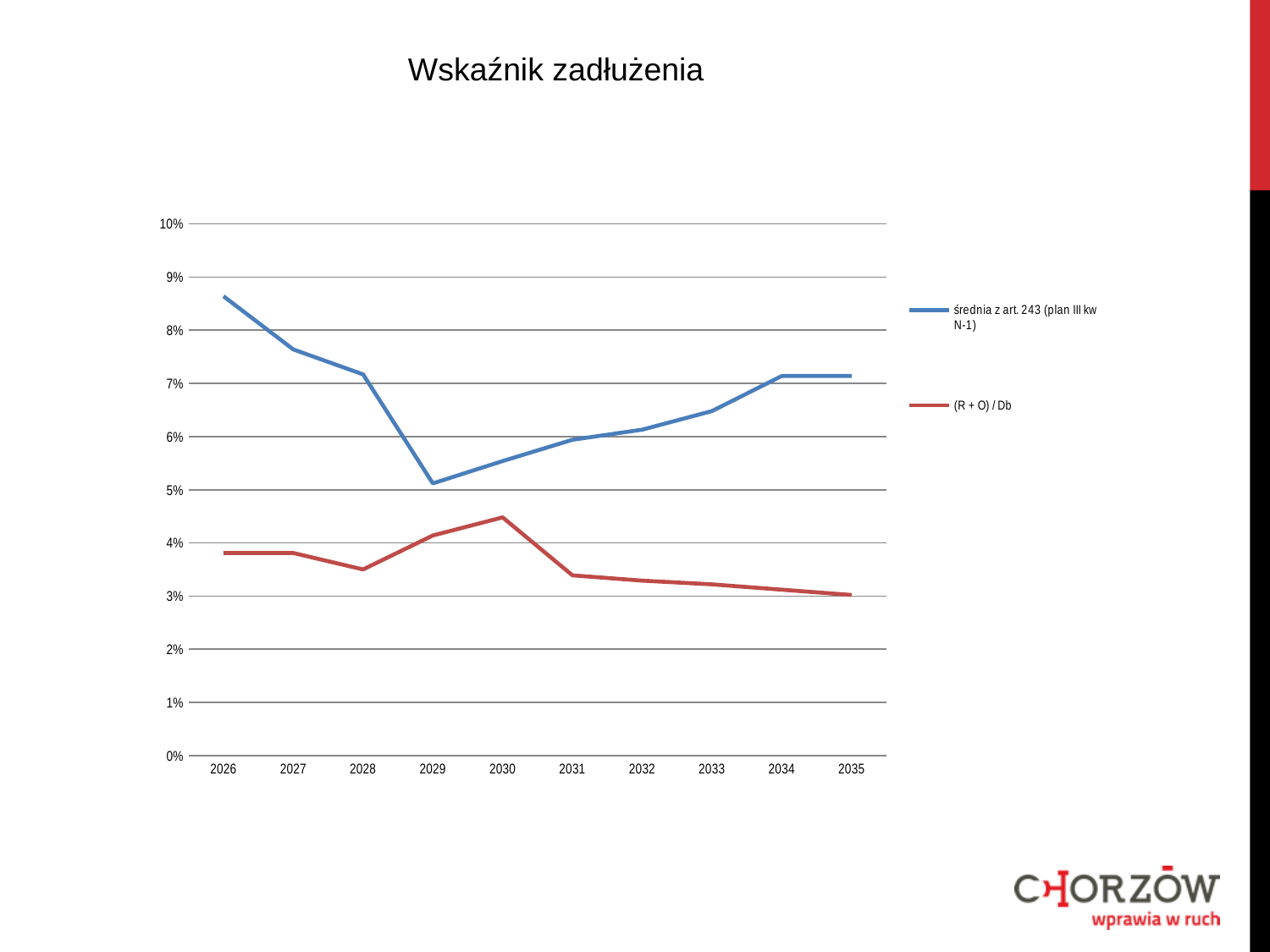
Which series is drawn in red? (R + O) / Db In which year is the value of '(R + O) / Db' highest? 2030 How many years are shown on the x axis? 10 What kind of chart is shown on the slide? line chart Does the value of 'średnia z art. 243 (plan III kw N-1)' rise or fall from 2026 to 2029? fall In which year is the value of 'średnia z art. 243 (plan III kw N-1)' lowest? 2029 Is the value for '(R + O) / Db' in 2030 greater or less than 4%? greater How many series does the legend list? 2 What is the title of the chart? Wskaźnik zadłużenia In which year is the value of 'średnia z art. 243 (plan III kw N-1)' highest? 2026 Which series has the larger value in 2029, 'średnia z art. 243 (plan III kw N-1)' or '(R + O) / Db'? średnia z art. 243 (plan III kw N-1) Is the value for 'średnia z art. 243 (plan III kw N-1)' in 2026 greater or less than 8%? greater